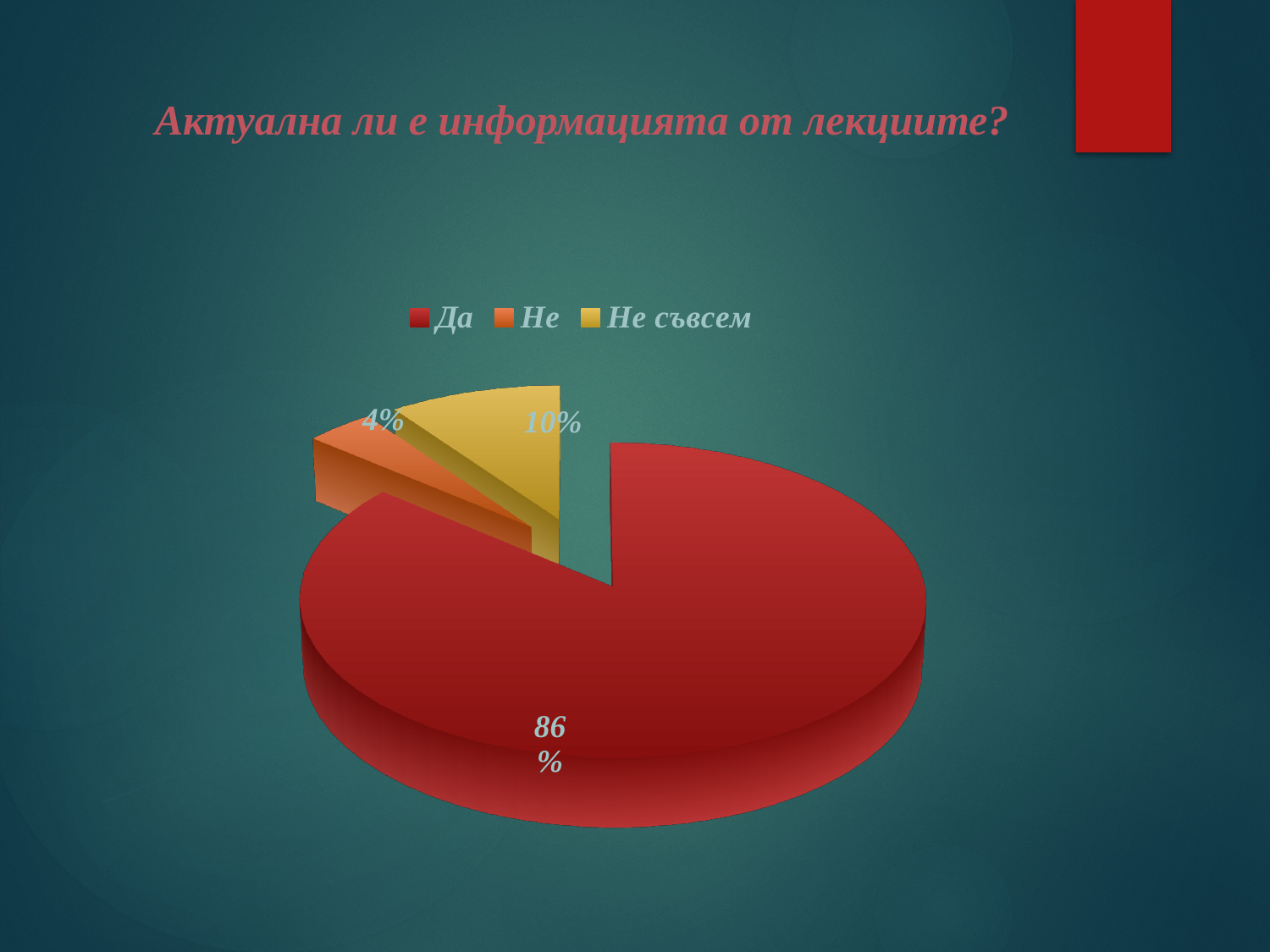
What kind of chart is shown on the slide? pie chart Which category has the largest slice of the pie? Да How many categories does the pie chart show? 3 What share of the pie does "Не съвсем" have? 10% What share of the pie does "Да" have? 86% How many entries does the legend list? 3 Which category has the smallest slice of the pie? Не What is the difference in percentage points between "Да" and "Не съвсем"? 76 What share of the pie does "Не" have? 4% Which is larger, the share for "Не" or the share for "Не съвсем"? Не съвсем What is the difference in percentage points between "Не съвсем" and "Не"? 6 What is the title of the chart? Актуална ли е информацията от лекциите?